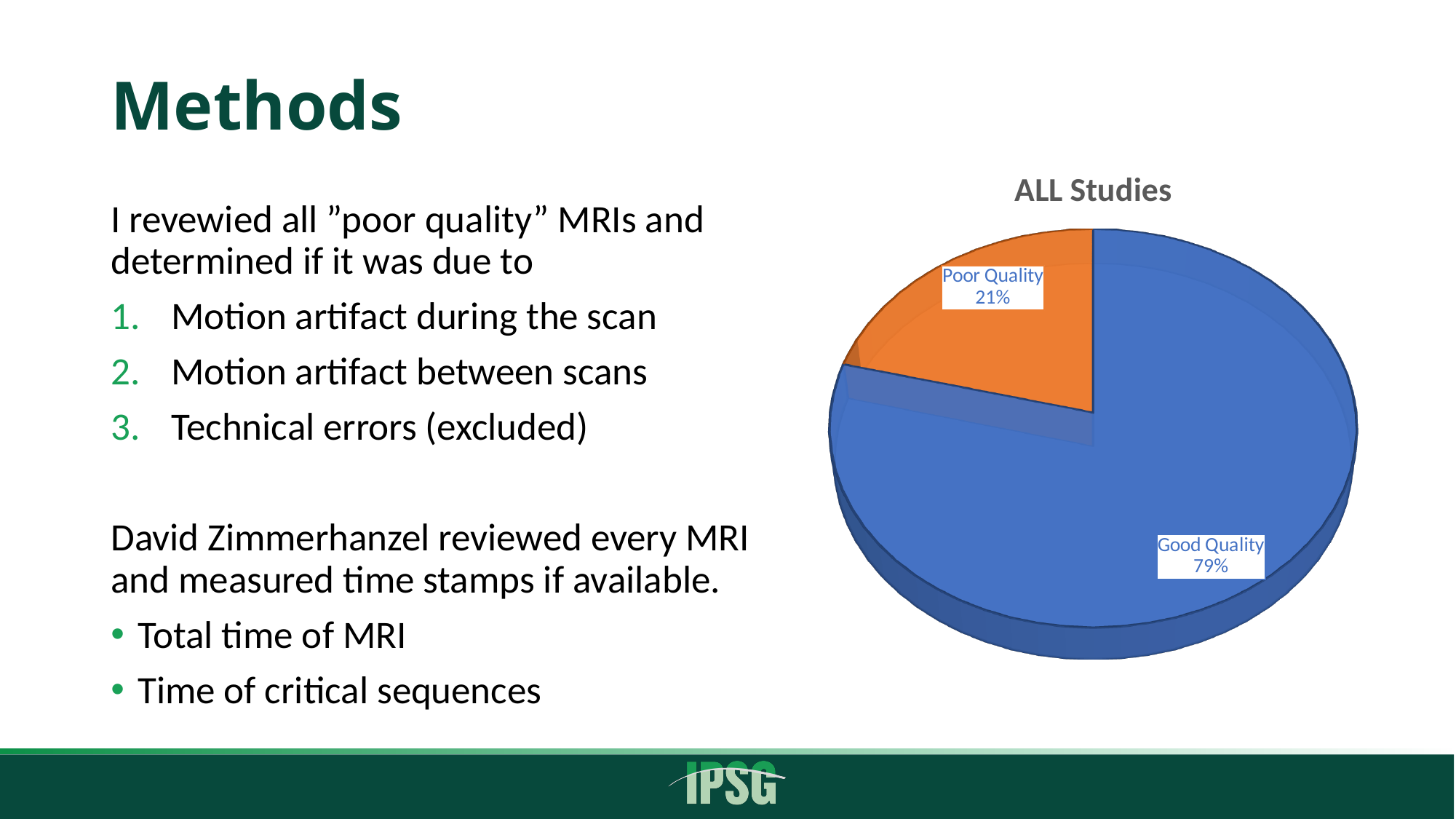
What kind of chart is shown on the slide? Pie chart What colour is the Poor Quality slice in the pie chart? Orange Which is larger in the ALL Studies chart, Good Quality or Poor Quality? Good Quality What is the title of the chart on the slide? ALL Studies How many slices does the ALL Studies pie chart have? 2 Which slice of the ALL Studies pie chart is the largest? Good Quality What percentage of studies are labelled Good Quality in the ALL Studies pie chart? 79% What is the difference in percentage points between the Good Quality and Poor Quality slices? 58 What share of the pie does the Poor Quality slice represent? 21% Which slice of the ALL Studies pie chart is the smallest? Poor Quality What percentage of studies are labelled Poor Quality in the ALL Studies pie chart? 21%